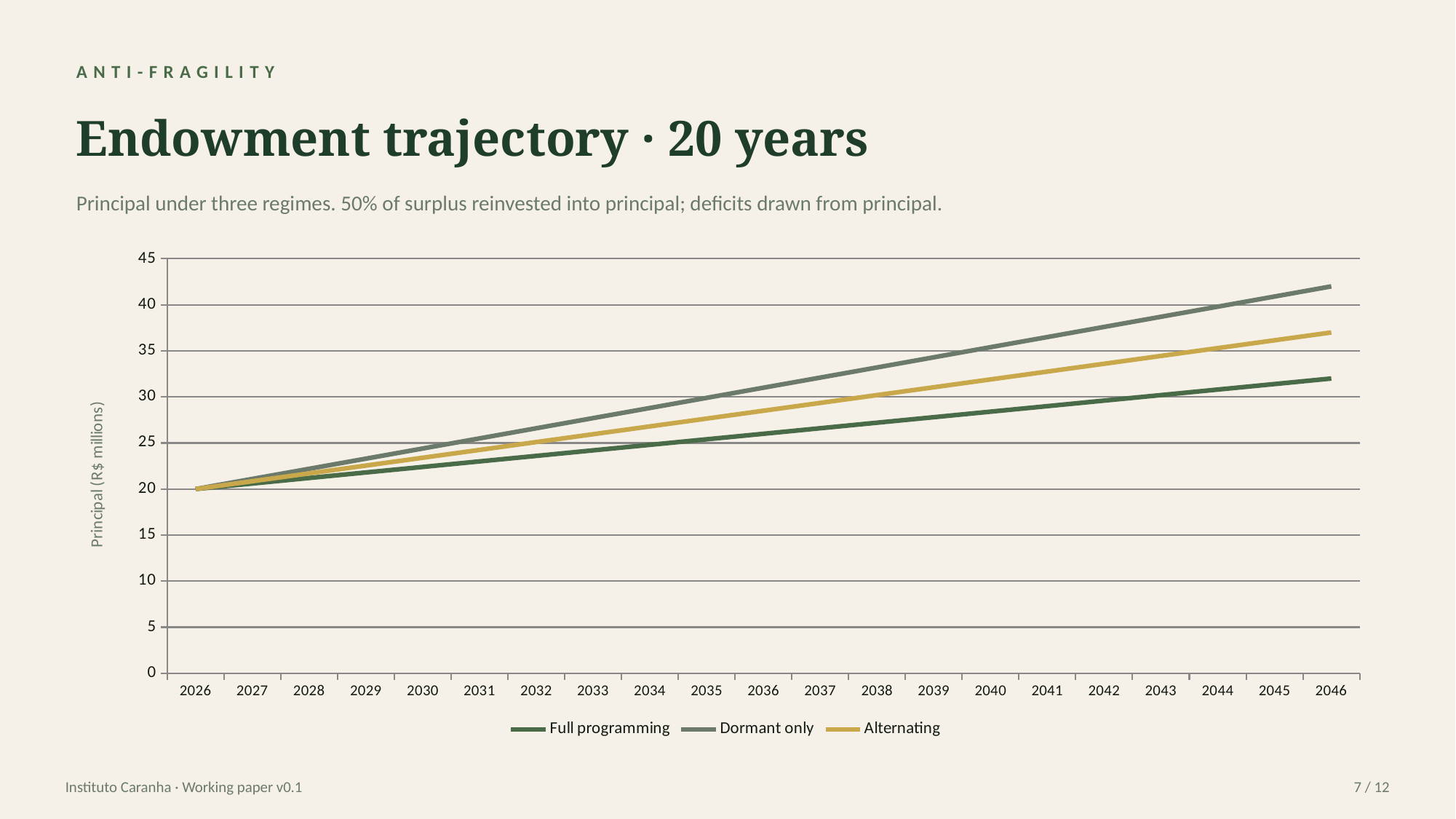
What is the label of the y axis? Principal (R$ millions) What kind of chart is shown on the slide? line chart Is the value for Dormant only in 2046 greater or less than 40? greater Which series has the highest value in 2046? Dormant only Is the value for Alternating in 2046 greater or less than 35? greater Which series has the lowest value in 2046? Full programming Is the value for Full programming in 2046 greater or less than 35? less What is the value of the Dormant only series in 2026? 20 Do the values of the Dormant only series rise or fall from 2026 to 2046? rise How many years are plotted along the x axis? 21 In 2040, which is larger: the Alternating value or the Full programming value? Alternating How many series does the legend list? 3